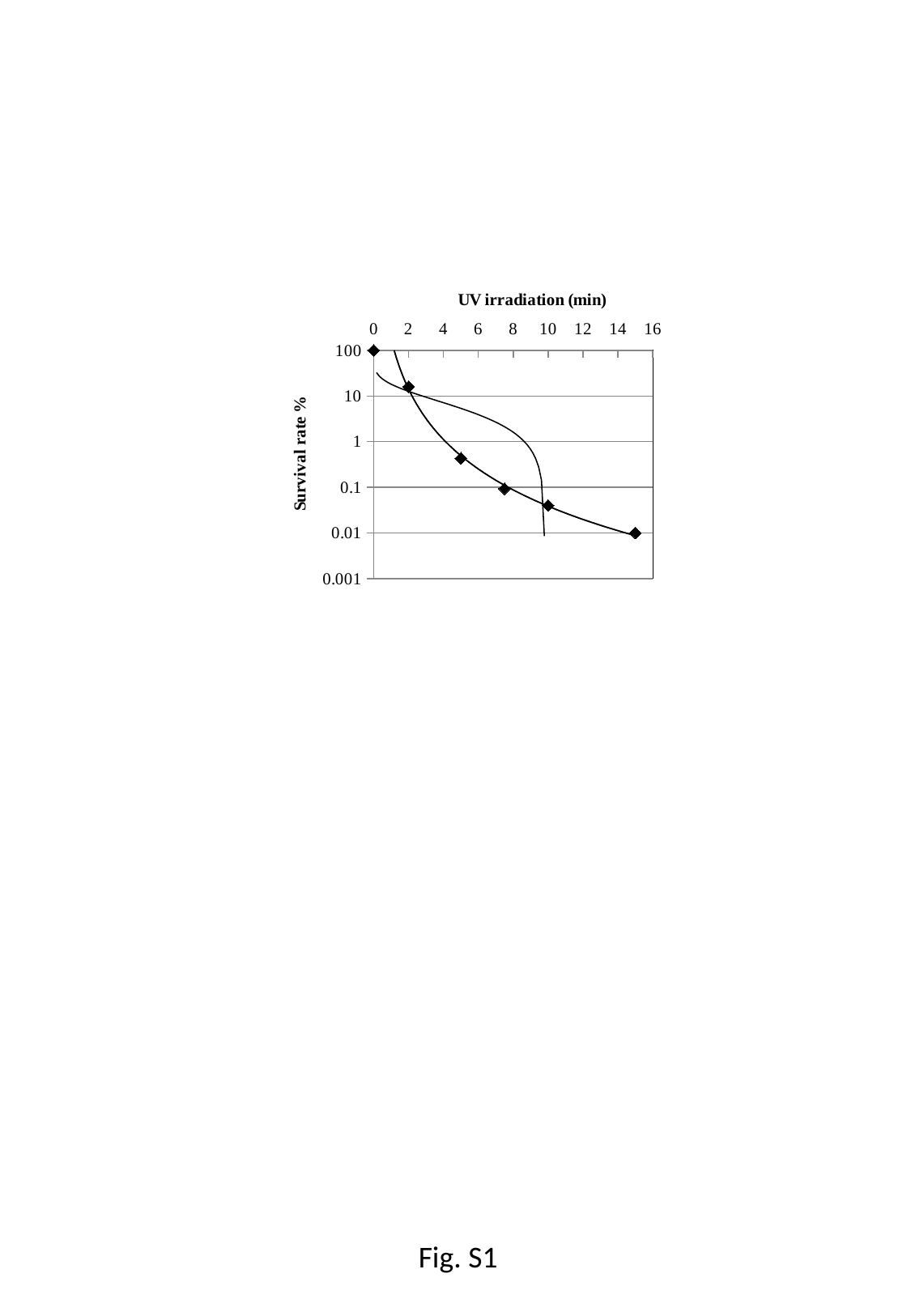
At which UV irradiation time is the survival rate highest? 0 min Which has the higher survival rate: 5 minutes or 10 minutes of UV irradiation? 5 minutes At which UV irradiation time is the survival rate lowest? 15 min What is the label of the y axis? Survival rate % What is the survival rate at 0 minutes of UV irradiation? 100 How many data points (diamond markers) are plotted on the chart? 6 Is the survival rate at 10 minutes greater or less than 0.1? less Is the survival rate at 2 minutes greater or less than 10? greater Is the survival rate at 5 minutes greater or less than 1? less What kind of chart is shown on the slide? Line chart (scatter with markers) What is the label of the x axis? UV irradiation (min) Does the survival rate rise or fall as UV irradiation time increases? Fall